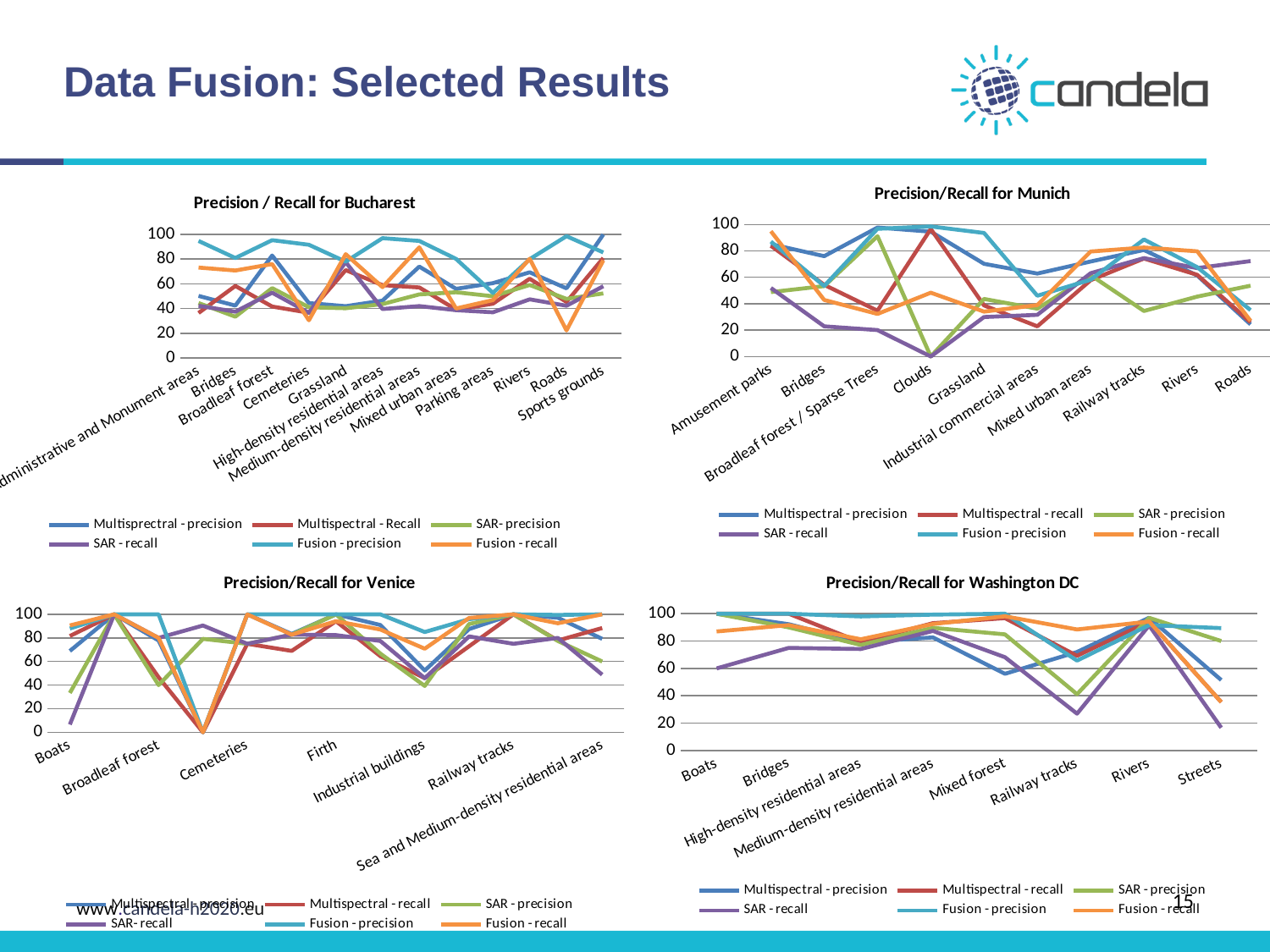
In the "Precision/Recall for Munich" chart, is the Multispectral - recall value for Clouds greater or less than 80? greater In the "Precision/Recall for Washington DC" chart, is the SAR - recall value for Streets greater or less than 40? less How many charts are shown on the slide? 4 In the "Precision/Recall for Munich" chart, how many categories are shown on the x axis? 10 How many series does the legend of the "Precision/Recall for Munich" chart list? 6 In the "Precision / Recall for Bucharest" chart, is the Fusion - recall value for Roads greater or less than 40? less In the "Precision / Recall for Bucharest" chart, how many categories are shown on the x axis? 12 What kind of chart is the "Precision / Recall for Bucharest" chart? line chart